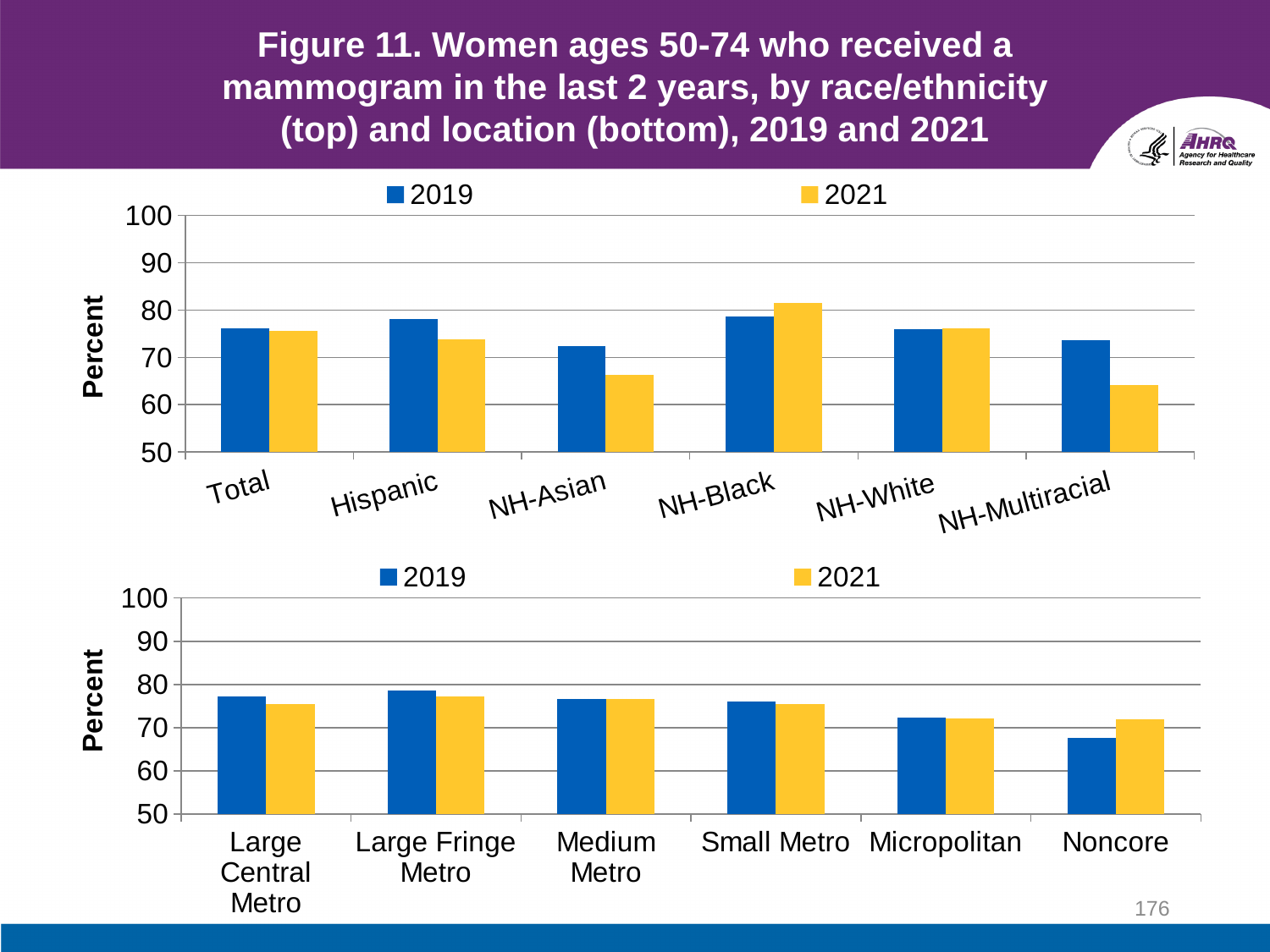
How many race/ethnicity categories are shown in the top chart? 6 In the bottom chart, is the 2019 value for Noncore greater or less than 70? less How many series does the legend of the top chart list? 2 In the top chart, which race/ethnicity group has the highest 2021 value? NH-Black What is the label on the vertical axis of the bottom chart? Percent In the top chart, is the 2021 value for NH-Asian greater or less than 70? less In the top chart, is the 2021 value for Hispanic greater or less than 70? greater What kind of chart is the top chart (by race/ethnicity)? bar chart In the bottom chart, for Noncore, which year has the larger value, 2019 or 2021? 2021 In the bottom chart (by location), which location has the lowest 2019 value? Noncore In the top chart, for NH-Black, which year has the larger value, 2019 or 2021? 2021